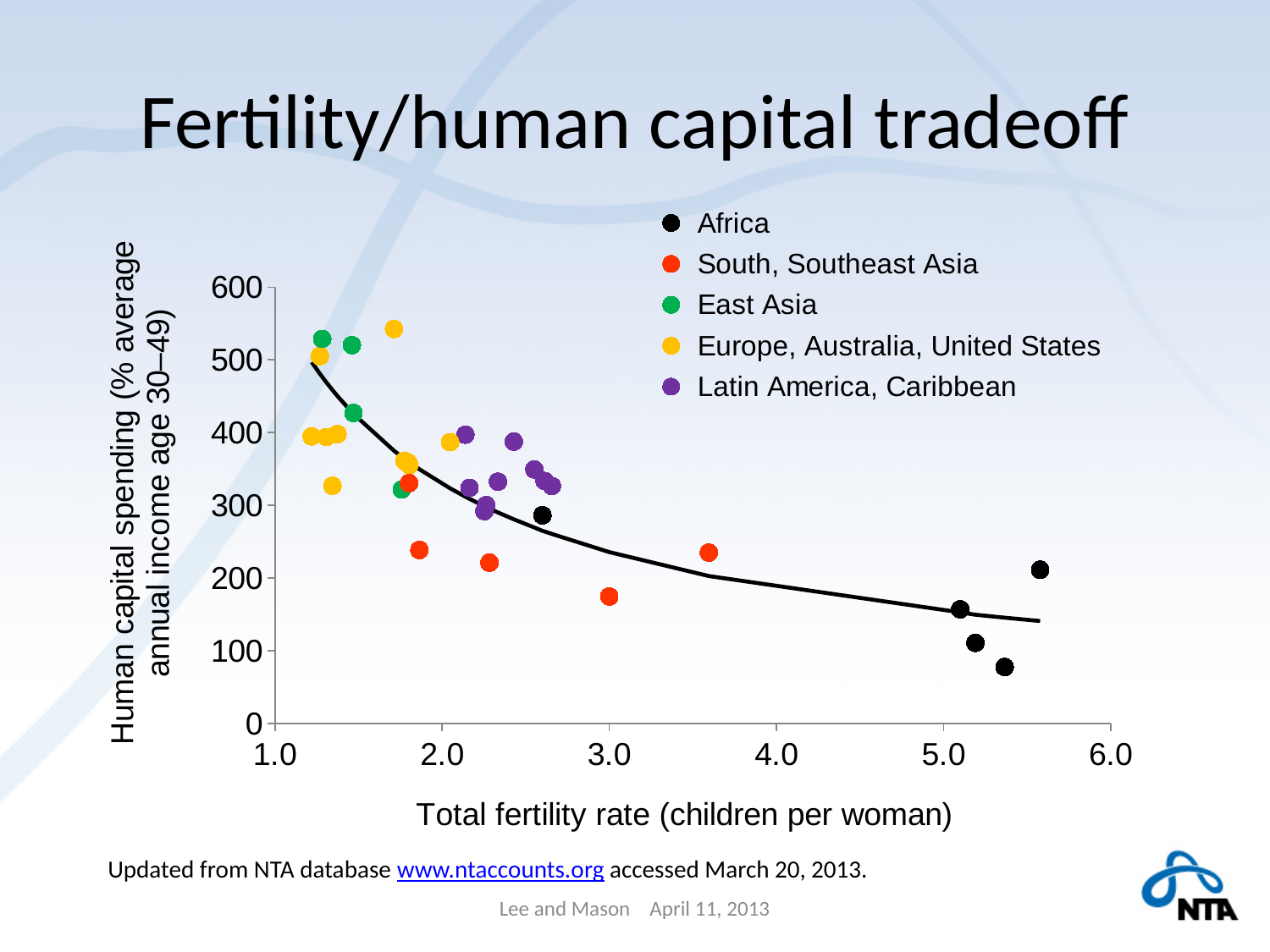
Which series has the points with the highest total fertility rates? Africa As the total fertility rate increases along the x axis, does human capital spending generally rise or fall? fall Is the lowest Africa point's human capital spending greater or less than 100? less Is the human capital spending for the Africa point at a fertility rate of about 5.6 greater or less than 100? greater Which series contains the point with the lowest human capital spending? Africa What kind of chart is shown on the slide? scatter chart How many Africa points are plotted on the chart? 5 How many series does the legend list? 5 Is the human capital spending for the highest Europe, Australia, United States point greater or less than 500? greater What is the title of the chart? Fertility/human capital tradeoff Which series is shown with black markers? Africa